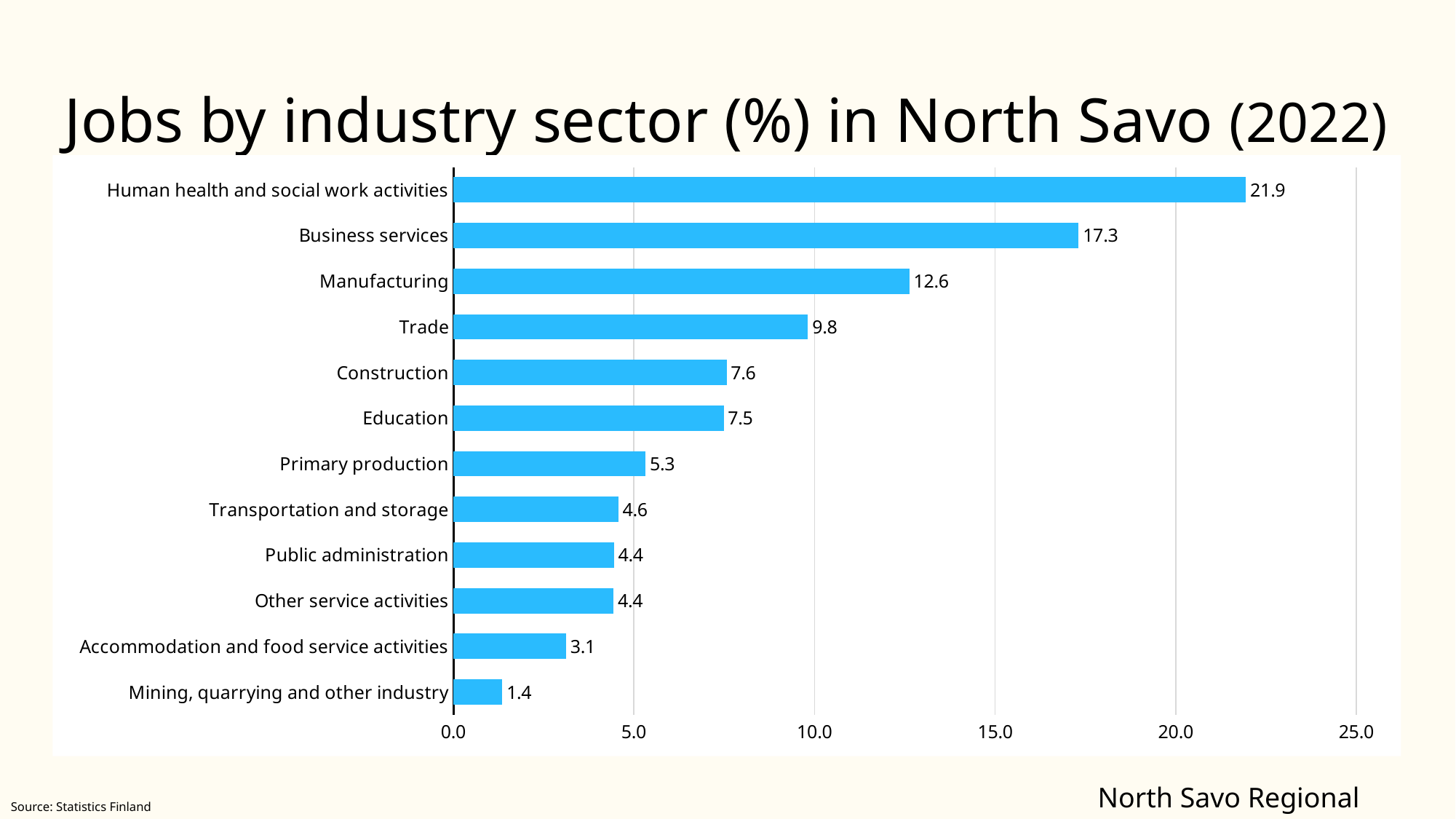
What is the value for Accommodation and food service activities? 3.1 What is the value for Transportation and storage? 4.6 What is the value for Manufacturing? 12.6 What kind of chart is shown on the slide? Bar chart What is the difference between the values for Trade and Primary production? 4.5 Which industry sector has the lowest share of jobs? Mining, quarrying and other industry Which industry sector has the highest share of jobs? Human health and social work activities How many industry sectors are shown in the chart? 12 What is the difference between the values for Business services and Manufacturing? 4.7 Is the value for Business services greater or less than 15.0? greater What is the title of the chart? Jobs by industry sector (%) in North Savo (2022) Which is larger, the value for Construction or the value for Primary production? Construction